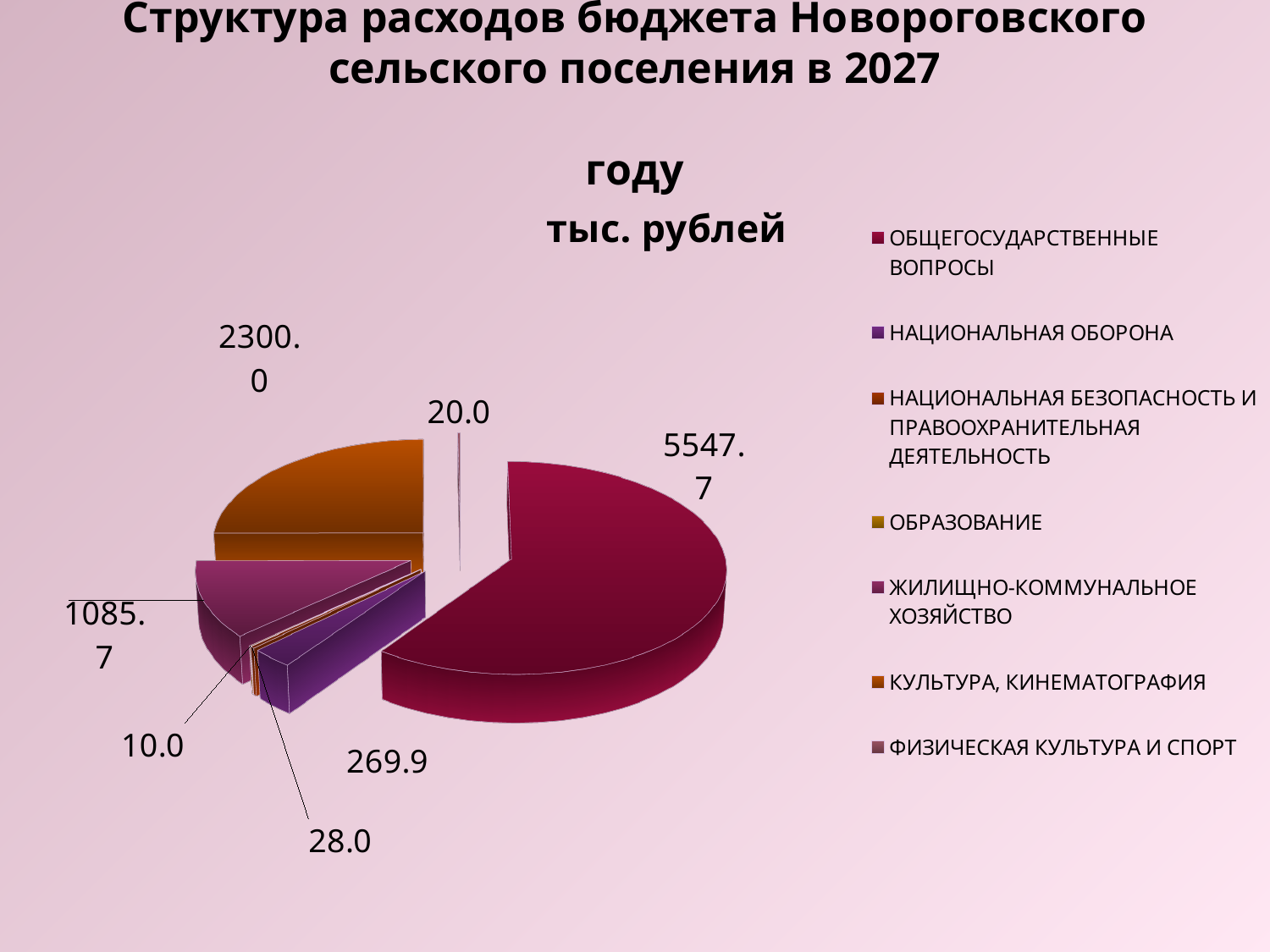
What is the value for НАЦИОНАЛЬНАЯ ОБОРОНА? 269.9 Which is larger, the value for ЖИЛИЩНО-КОММУНАЛЬНОЕ ХОЗЯЙСТВО or the value for НАЦИОНАЛЬНАЯ ОБОРОНА? ЖИЛИЩНО-КОММУНАЛЬНОЕ ХОЗЯЙСТВО What is the value for КУЛЬТУРА, КИНЕМАТОГРАФИЯ? 2300.0 What is the difference between the values for ОБЩЕГОСУДАРСТВЕННЫЕ ВОПРОСЫ and КУЛЬТУРА, КИНЕМАТОГРАФИЯ? 3247.7 What is the difference between the values for КУЛЬТУРА, КИНЕМАТОГРАФИЯ and ЖИЛИЩНО-КОММУНАЛЬНОЕ ХОЗЯЙСТВО? 1214.3 How many categories does the legend of the pie chart list? 7 What is the value for ЖИЛИЩНО-КОММУНАЛЬНОЕ ХОЗЯЙСТВО? 1085.7 What is the value for ОБЩЕГОСУДАРСТВЕННЫЕ ВОПРОСЫ? 5547.7 What is the smallest value labelled on the pie chart? 10.0 Which category has the largest share of the pie? ОБЩЕГОСУДАРСТВЕННЫЕ ВОПРОСЫ In what units are the values of the pie chart given, according to the chart subtitle? тыс. рублей What type of chart is shown on the slide? pie chart